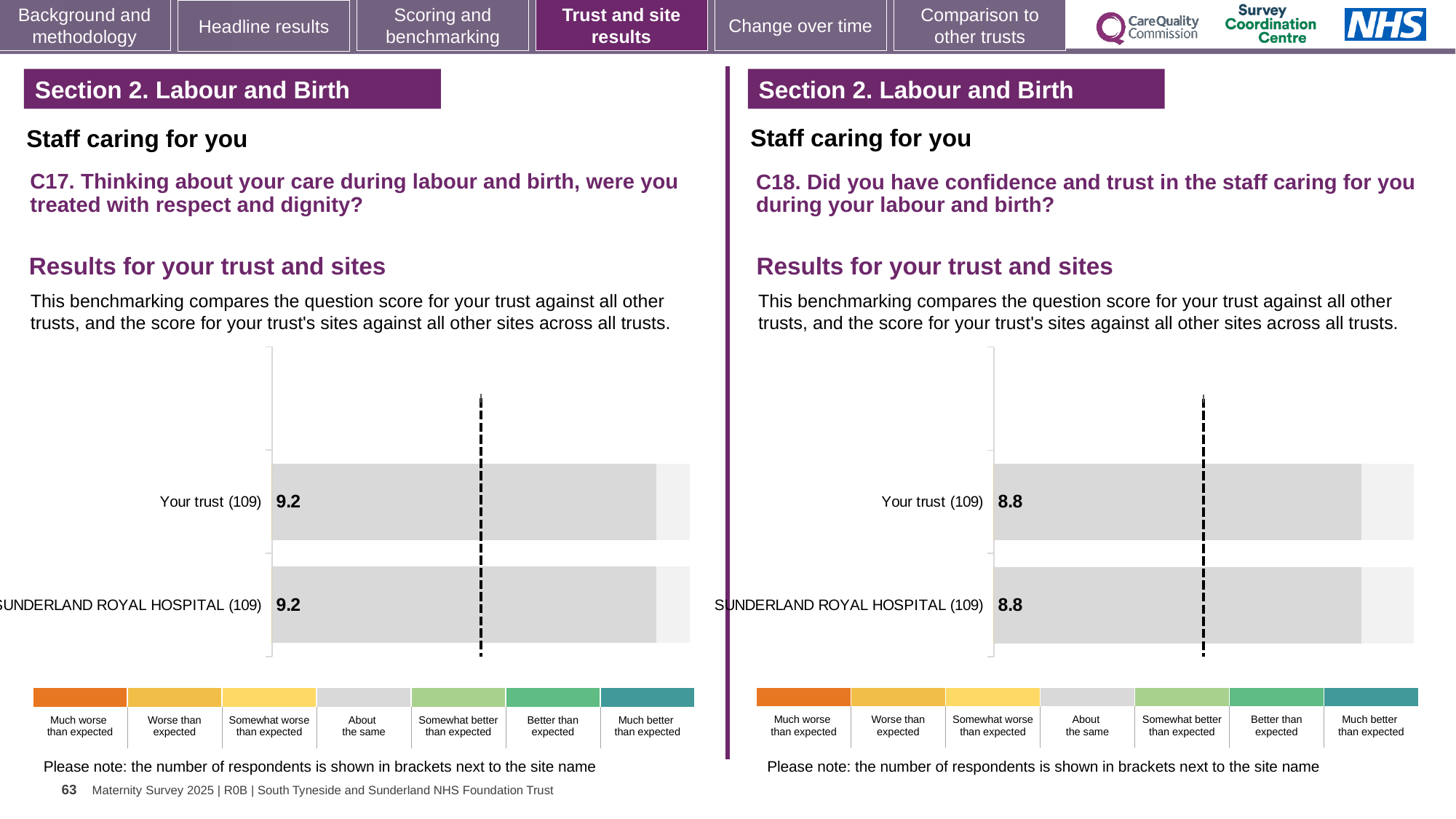
On the left chart (C17), what is the score for Your trust? 9.2 On the right chart (C18), what is the score for SUNDERLAND ROYAL HOSPITAL? 8.8 How many bars are plotted on the left chart (C17)? 2 On the left chart (C17), what is the difference between the Your trust score and the SUNDERLAND ROYAL HOSPITAL score? 0 On the left chart (C17), what is the score for SUNDERLAND ROYAL HOSPITAL? 9.2 What is the difference between the Your trust score on the left chart (C17) and the Your trust score on the right chart (C18)? 0.4 Which is larger: the Your trust score on the left chart (C17) or the Your trust score on the right chart (C18)? Left chart (C17) On the left chart (C17), how many respondents are shown in brackets next to SUNDERLAND ROYAL HOSPITAL? 109 On the right chart (C18), what is the score for Your trust? 8.8 What kind of chart is used on the right (C18)? Bar chart How many bars are plotted on the right chart (C18)? 2 How many categories does the colour legend below the right chart (C18) list? 7